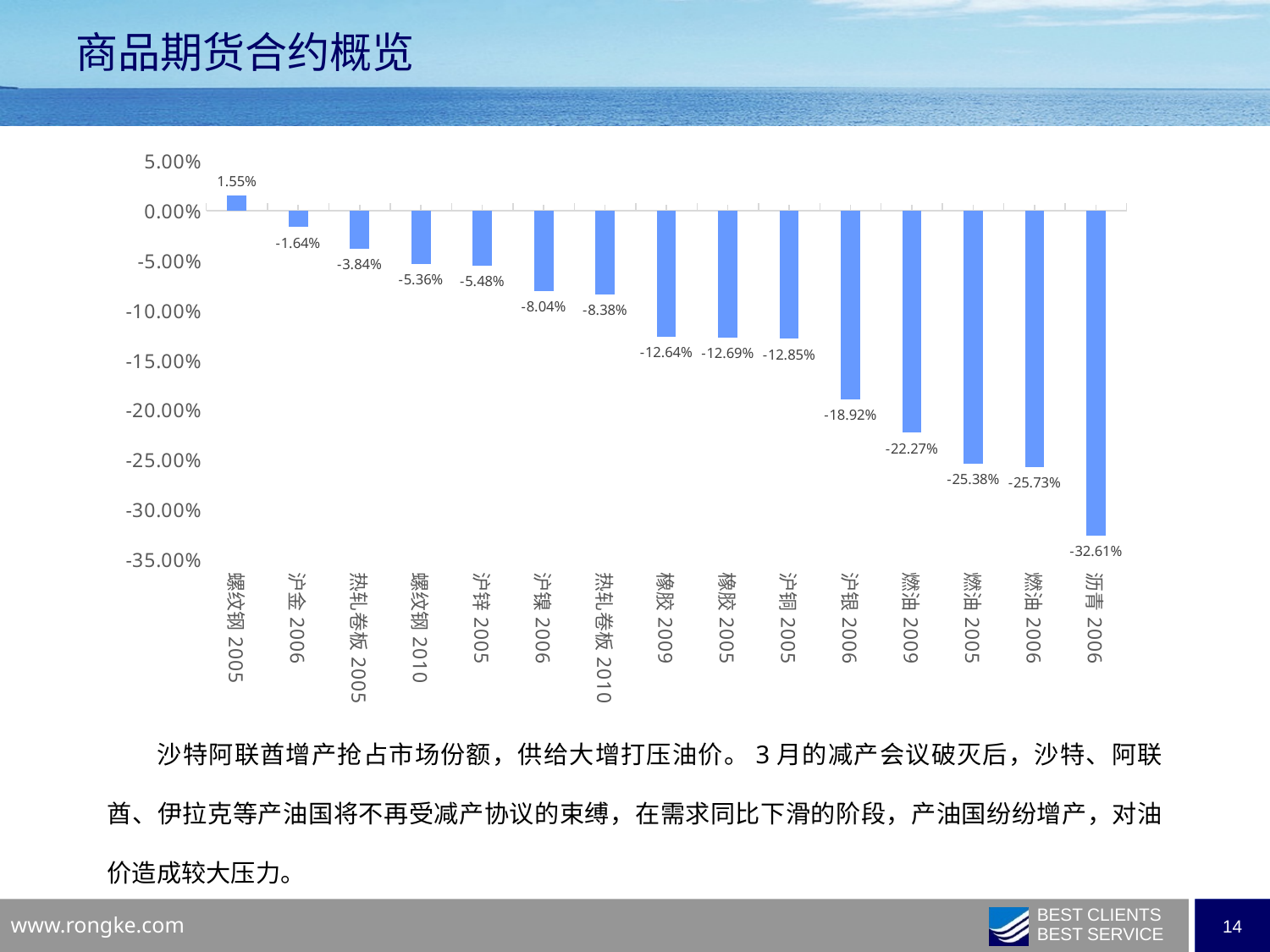
What is the value for 螺纹钢 2005? 1.55% Which category has the highest value? 螺纹钢 2005 Do the values rise or fall moving from left to right along the x axis? Fall What is the value for 沪银 2006? -18.92% How many categories are shown on the x axis? 15 Which is larger, the value for 沪金 2006 or the value for 沪锌 2005? 沪金 2006 What is the title of the slide? 商品期货合约概览 What is the value for 沥青 2006? -32.61% Which category has the lowest value? 沥青 2006 What is the difference between the values for 燃油 2009 and 燃油 2005? 3.11% What is the value for 热轧卷板 2010? -8.38% What kind of chart is shown on the slide? Bar chart